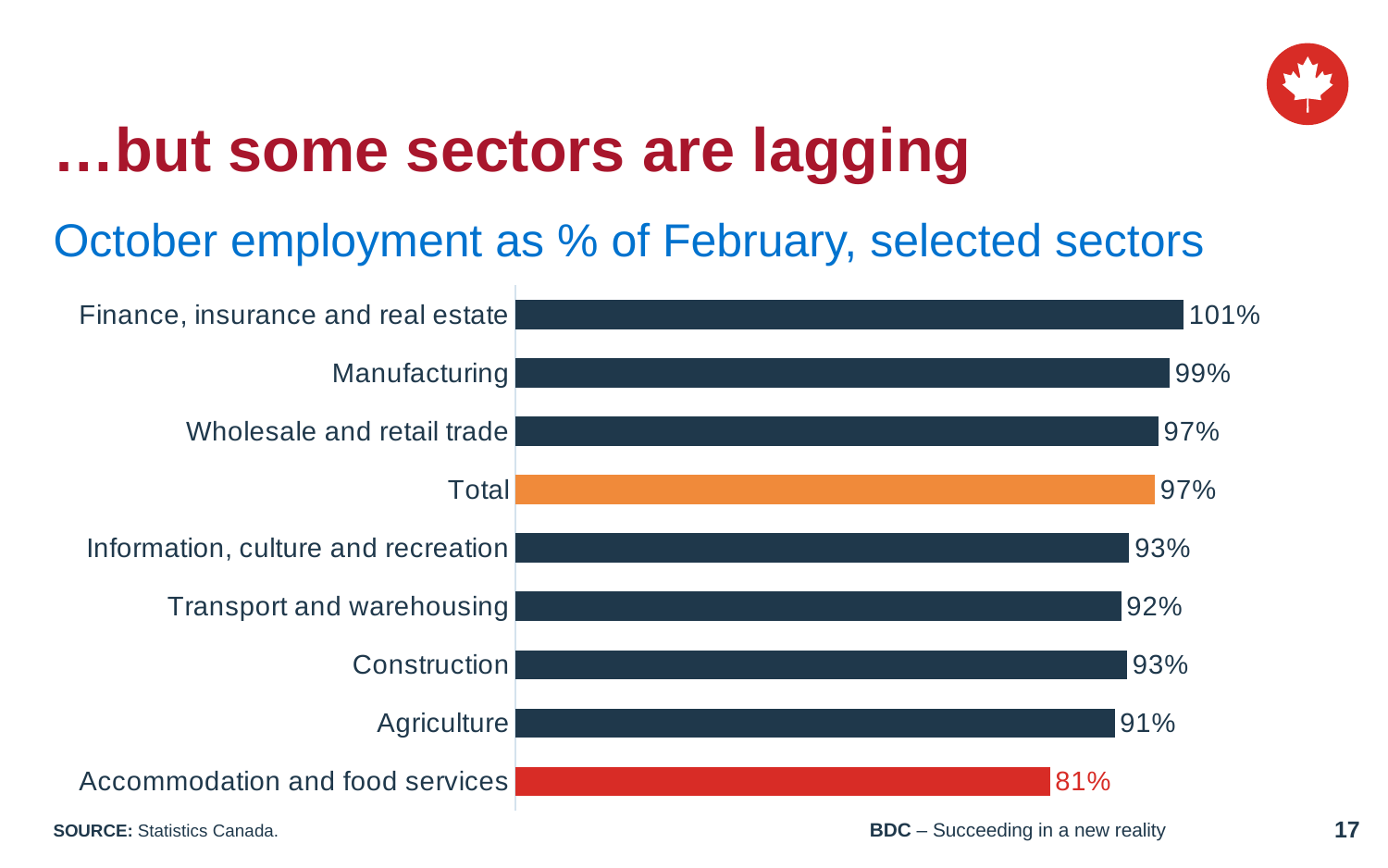
Which is larger, the value for Construction or the value for Agriculture? Construction Which sector has the lowest value? Accommodation and food services How many categories are shown in the chart? 9 What is the value for Manufacturing? 99% Which sector has the highest value? Finance, insurance and real estate What is the title of the chart? October employment as % of February, selected sectors What is the value for Accommodation and food services? 81% What is the value for Agriculture? 91% What is the difference between the values for Finance, insurance and real estate and Accommodation and food services? 20 percentage points What kind of chart is shown on the slide? Bar chart What is the value for Transport and warehousing? 92% Which bar is coloured orange? Total